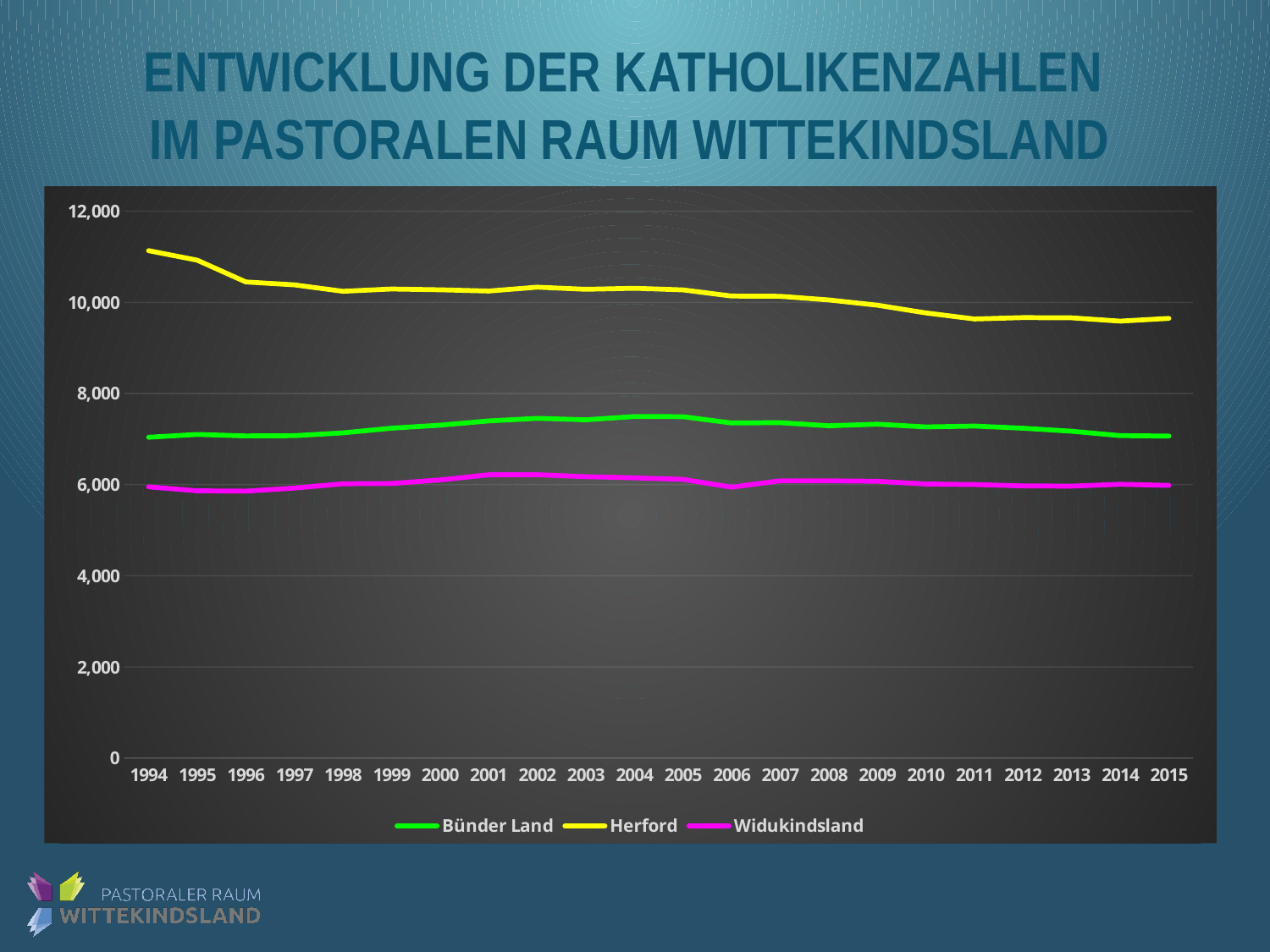
What colour is the Herford line in the chart? yellow Is the value for Herford in 1994 greater or less than 10,000? greater How many series does the legend list? 3 Is the value for Herford in 2015 greater or less than 10,000? less Does the Herford line rise or fall from 1994 to 2015? fall What kind of chart is shown on the slide? line chart How many years are shown along the x axis? 22 Which series has the lowest values throughout the chart? Widukindsland Which series has the highest values throughout the chart? Herford Is the value for Bünder Land in 1994 greater or less than 6,000? greater In 2010, which is larger: the value for Herford or the value for Bünder Land? Herford